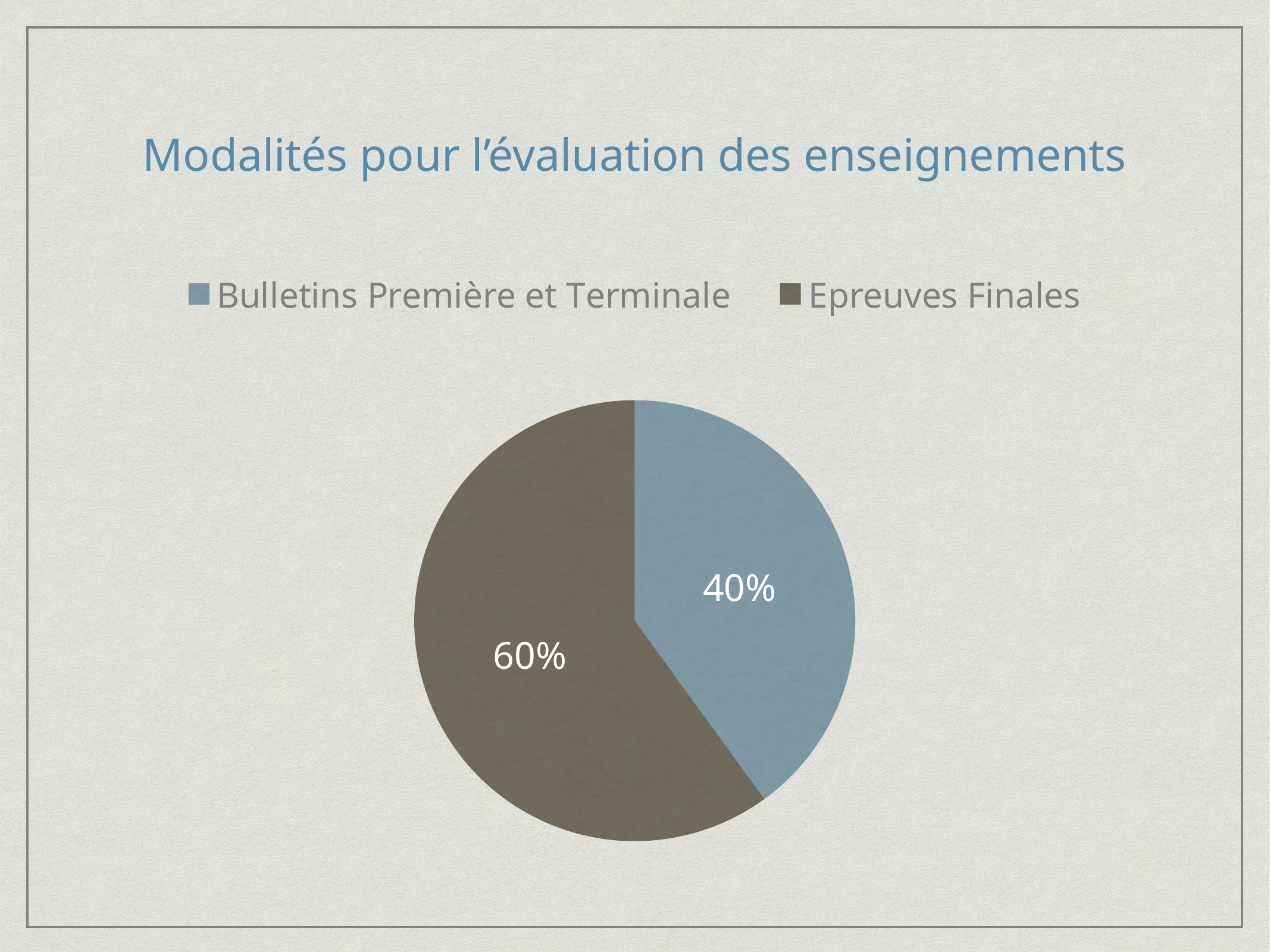
What is the title of the chart? Modalités pour l'évaluation des enseignements Which slice is the largest? Epreuves Finales Which colour represents Epreuves Finales in the chart? dark brown/grey Which slice is the smallest? Bulletins Première et Terminale What share of the pie does Epreuves Finales represent? 60% What share of the pie does Bulletins Première et Terminale represent? 40% Which is larger, Bulletins Première et Terminale or Epreuves Finales? Epreuves Finales How many entries does the legend list? 2 What is the difference between the Epreuves Finales share and the Bulletins Première et Terminale share? 20% How many slices does the pie chart have? 2 What kind of chart is shown on the slide? pie chart